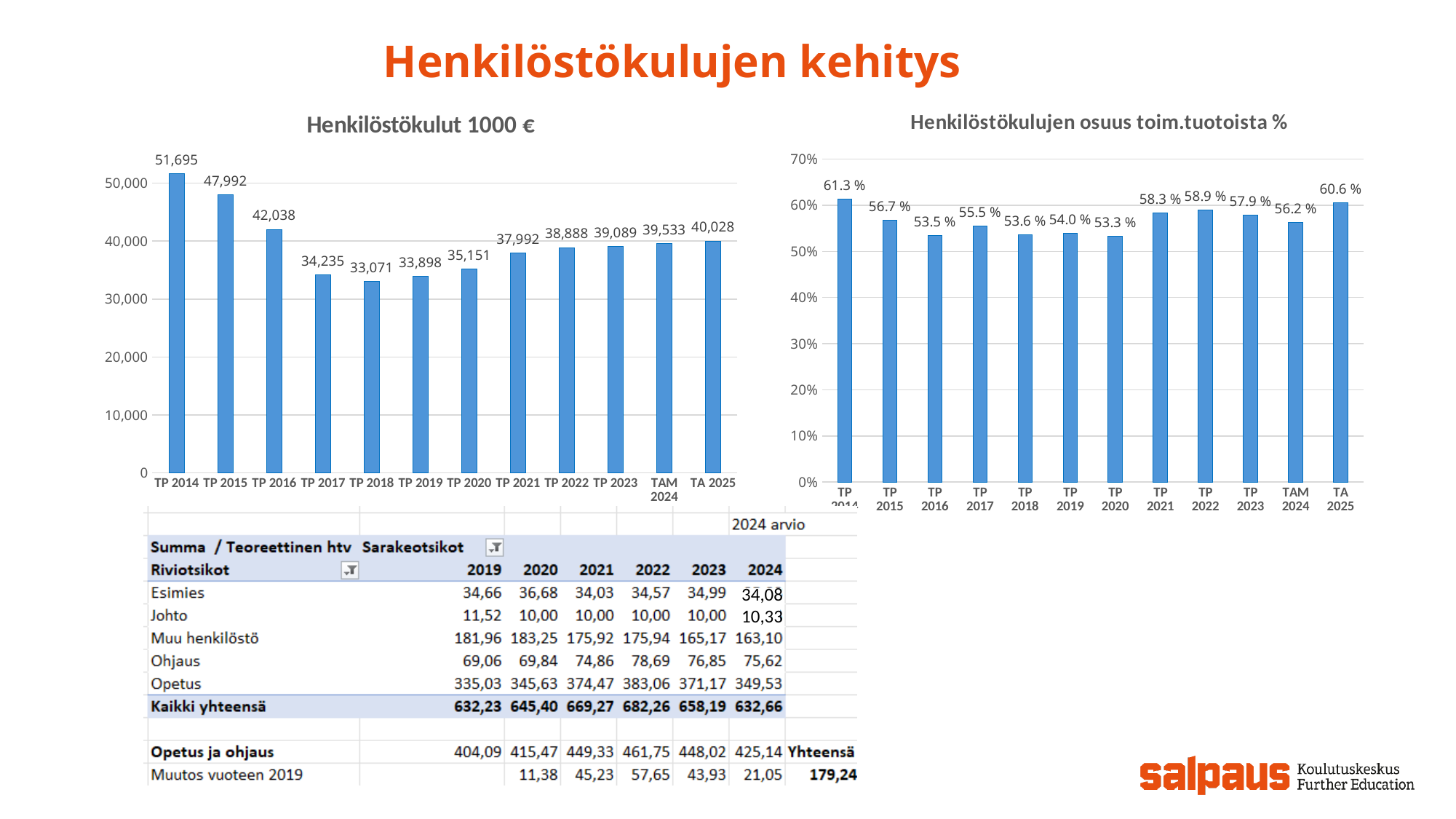
In the chart 'Henkilöstökulujen osuus toim.tuotoista %', which category has the lowest value? TP 2020 What kind of chart is 'Henkilöstökulujen osuus toim.tuotoista %'? bar chart In the chart 'Henkilöstökulut 1000 €', what is the value for TP 2014? 51,695 In the chart 'Henkilöstökulut 1000 €', how many bars are plotted? 12 In the chart 'Henkilöstökulujen osuus toim.tuotoista %', is the value for TP 2019 greater or less than 50%? greater In the chart 'Henkilöstökulujen osuus toim.tuotoista %', which is larger, TP 2021 or TAM 2024? TP 2021 In the chart 'Henkilöstökulut 1000 €', what is the difference between TP 2014 and TP 2015? 3,703 In the chart 'Henkilöstökulujen osuus toim.tuotoista %', what is the value for TP 2022? 58.9 % In the chart 'Henkilöstökulut 1000 €', which category has the lowest value? TP 2018 In the chart 'Henkilöstökulut 1000 €', do the values rise or fall from TP 2018 to TA 2025? rise In the chart 'Henkilöstökulut 1000 €', what is the value for TA 2025? 40,028 In the chart 'Henkilöstökulujen osuus toim.tuotoista %', which category has the highest value? TP 2014